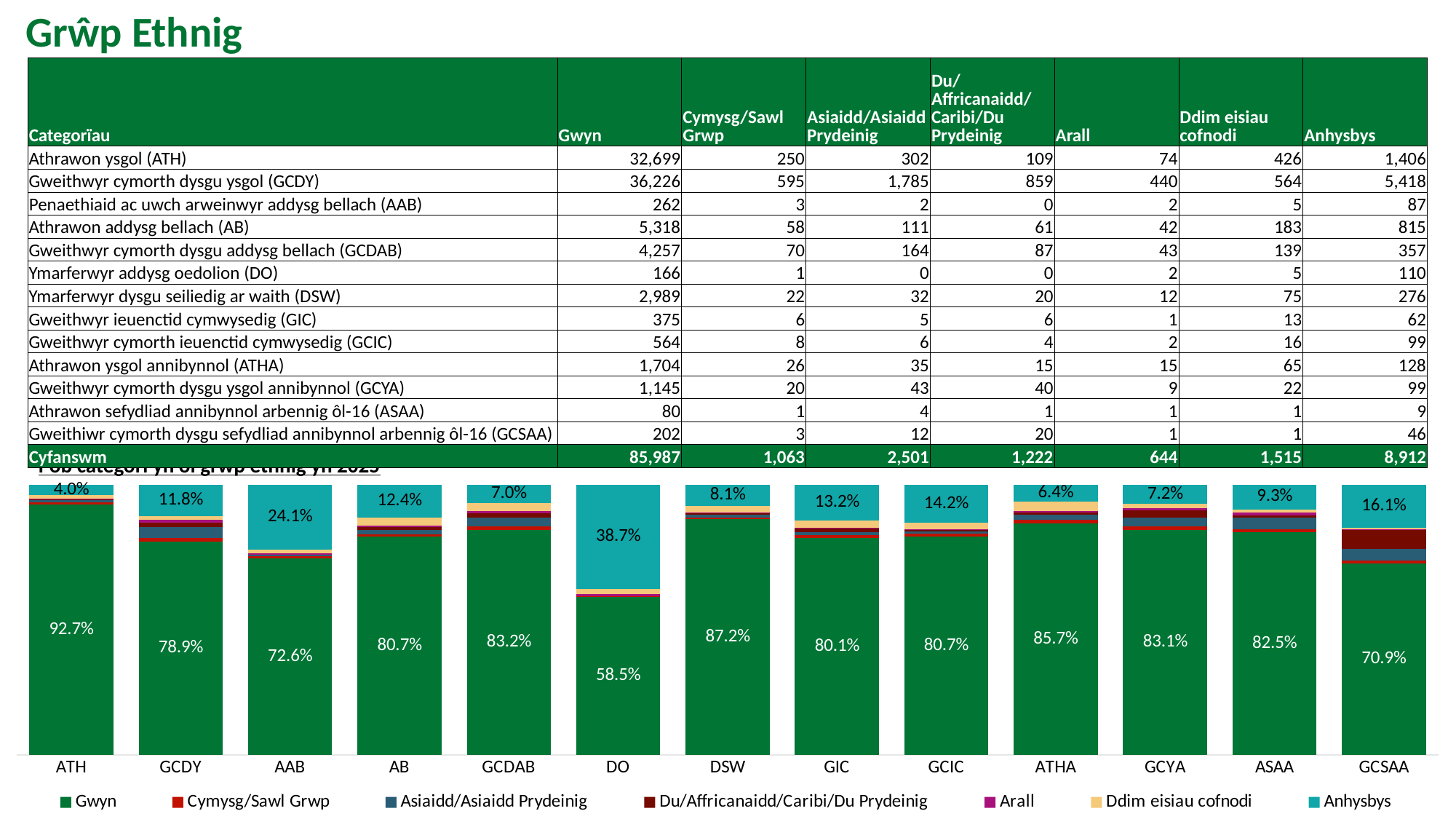
In the stacked bar chart, what is the Gwyn share for GCSAA? 70.9% In the stacked bar chart, which category has the highest Gwyn share? ATH In the stacked bar chart, what is the Anhysbys share for AAB? 24.1% In the stacked bar chart, which category has the lowest Anhysbys share? ATH In the stacked bar chart, what is the Anhysbys share for DO? 38.7% What kind of chart is shown below the table? stacked bar chart In the stacked bar chart, which category has the lowest Gwyn share? DO How many series does the legend of the stacked bar chart list? 7 In the stacked bar chart, which has the larger Gwyn share, GCDY or AAB? GCDY In the stacked bar chart, what is the difference in percentage points between the Gwyn share for ATH and the Gwyn share for DO? 34.2 percentage points In the stacked bar chart, what is the Gwyn share for ATH? 92.7% How many categories are shown on the x axis of the stacked bar chart? 13